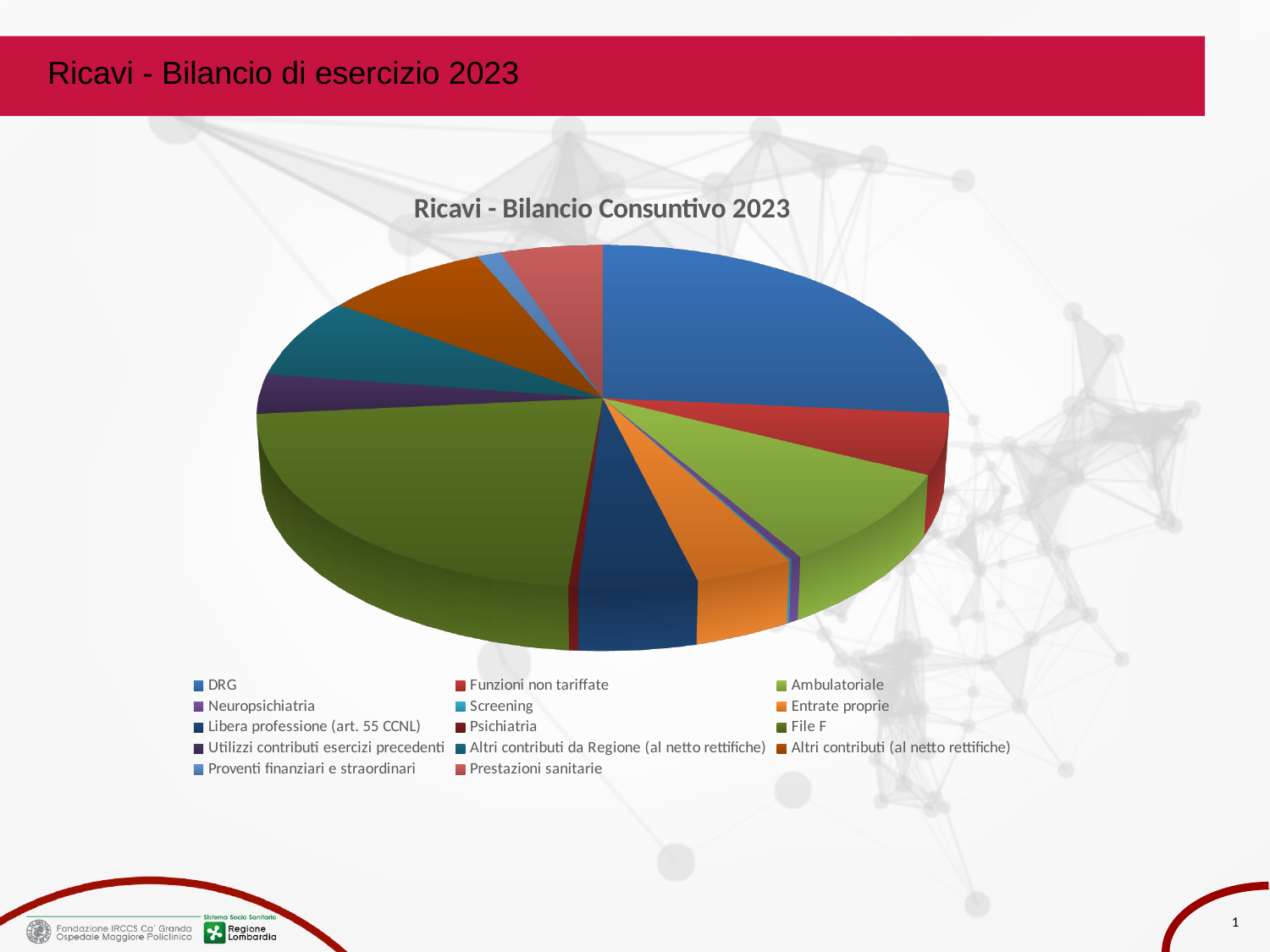
What colour is the DRG slice in the pie chart? blue Which is larger in the pie chart, the slice for File F or the slice for Screening? File F What is the title of the chart? Ricavi - Bilancio Consuntivo 2023 Which is larger in the pie chart, the slice for Entrate proprie or the slice for Utilizzi contributi esercizi precedenti? Entrate proprie Which is larger in the pie chart, the slice for Ambulatoriale or the slice for Neuropsichiatria? Ambulatoriale How many categories does the legend of the pie chart list? 14 What kind of chart is shown on the slide? pie chart